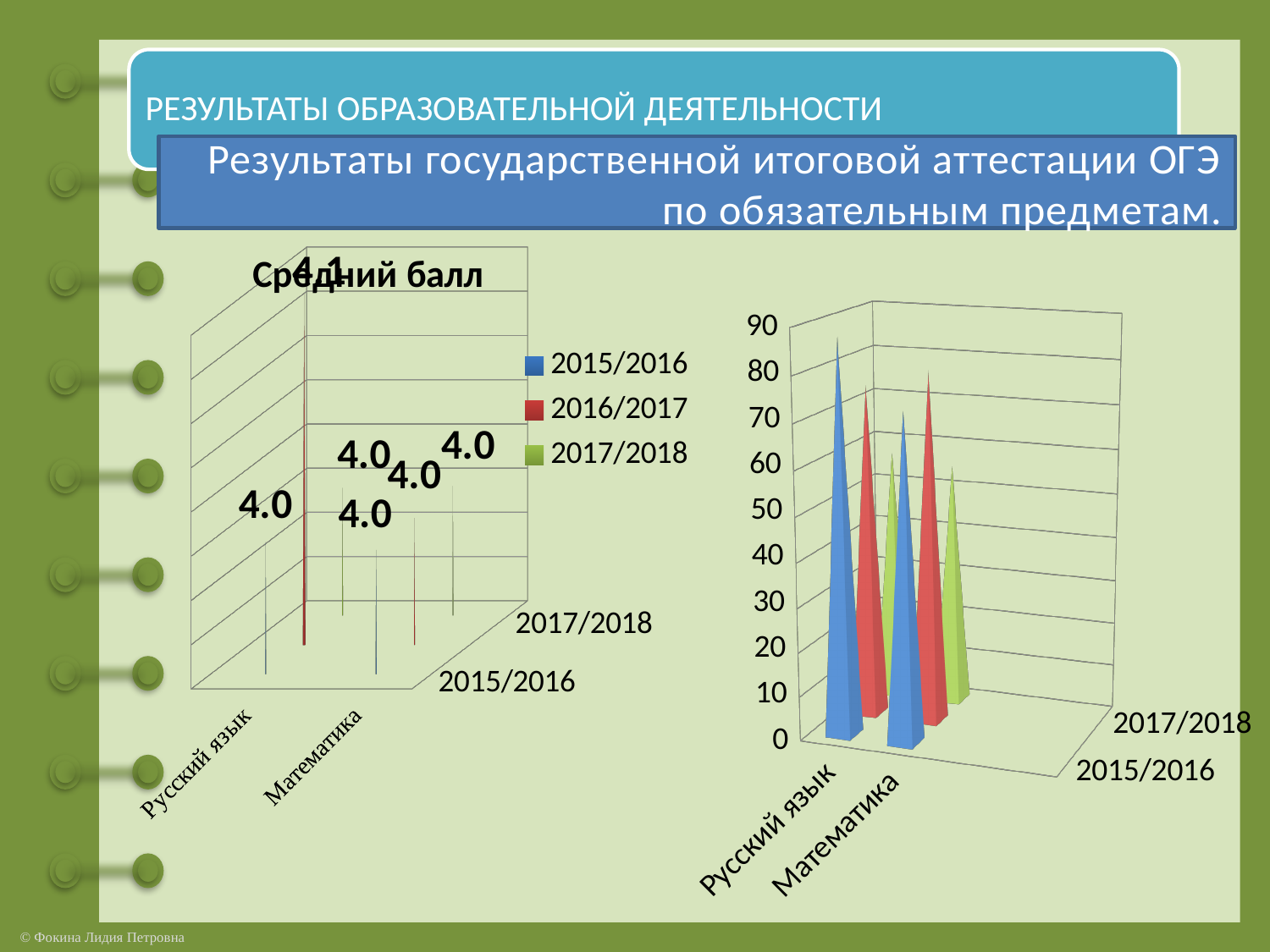
Which series is shown in red in the left chart's legend? 2016/2017 On the left chart (Средний балл), what is the value for Русский язык in 2016/2017? 4.1 On the right chart, which is larger for Математика: the 2016/2017 value or the 2017/2018 value? 2016/2017 How many subject categories are shown on the left chart (Средний балл)? 2 On the right chart, is the value for Математика in 2016/2017 greater or less than 60? greater How many series does the legend of the left chart list? 3 What is the highest value printed as a data label on the left chart (Средний балл)? 4.1 On the right chart, is the value for Математика in 2017/2018 greater or less than 70? less On the right chart, is the value for Русский язык in 2015/2016 greater or less than 70? greater What is the title of the chart on the left? Средний балл On the right chart, which is larger for Русский язык: the 2015/2016 value or the 2017/2018 value? 2015/2016 On the left chart (Средний балл), what is the value for Математика in 2017/2018? 4.0